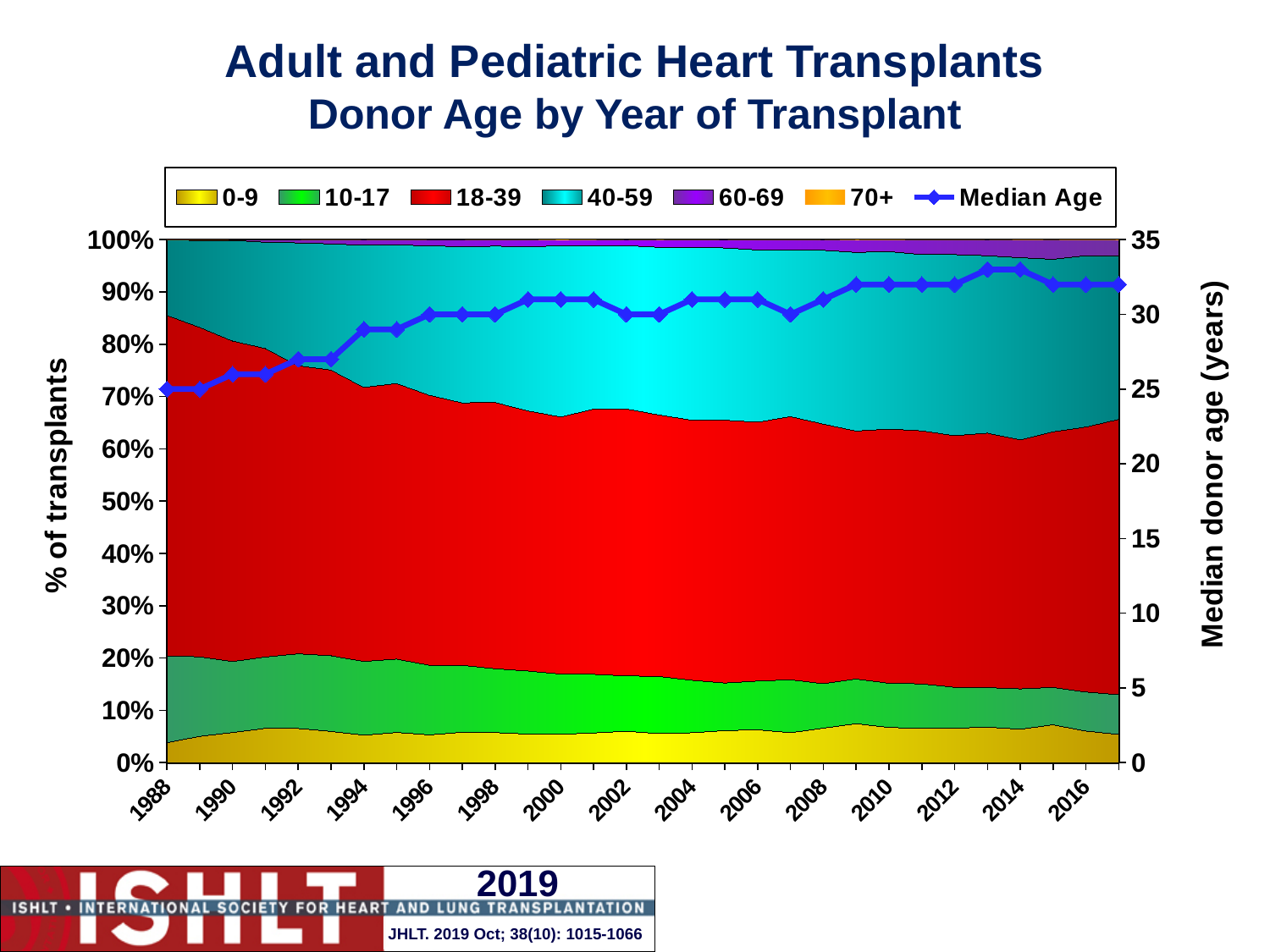
How many series does the legend list? 7 Is the median donor age in 1988 greater or less than 30 years? less Does the median donor age rise or fall from 1988 to 2016? Rises Is the median donor age in 2000 greater or less than 25 years? greater Which donor age group accounts for the largest share of transplants across the years shown? 18-39 Does the share of transplants from 40-59 year old donors rise or fall over the years shown? Rises What is the label of the right-hand vertical axis? Median donor age (years) What is the title of the chart? Adult and Pediatric Heart Transplants Donor Age by Year of Transplant Is the median donor age in 2016 greater or less than 30 years? greater Which is larger, the median donor age in 2014 or in 1990? 2014 Does the share of transplants from 18-39 year old donors rise or fall over the years shown? Falls What kind of chart is this? Stacked area chart with a line for median age